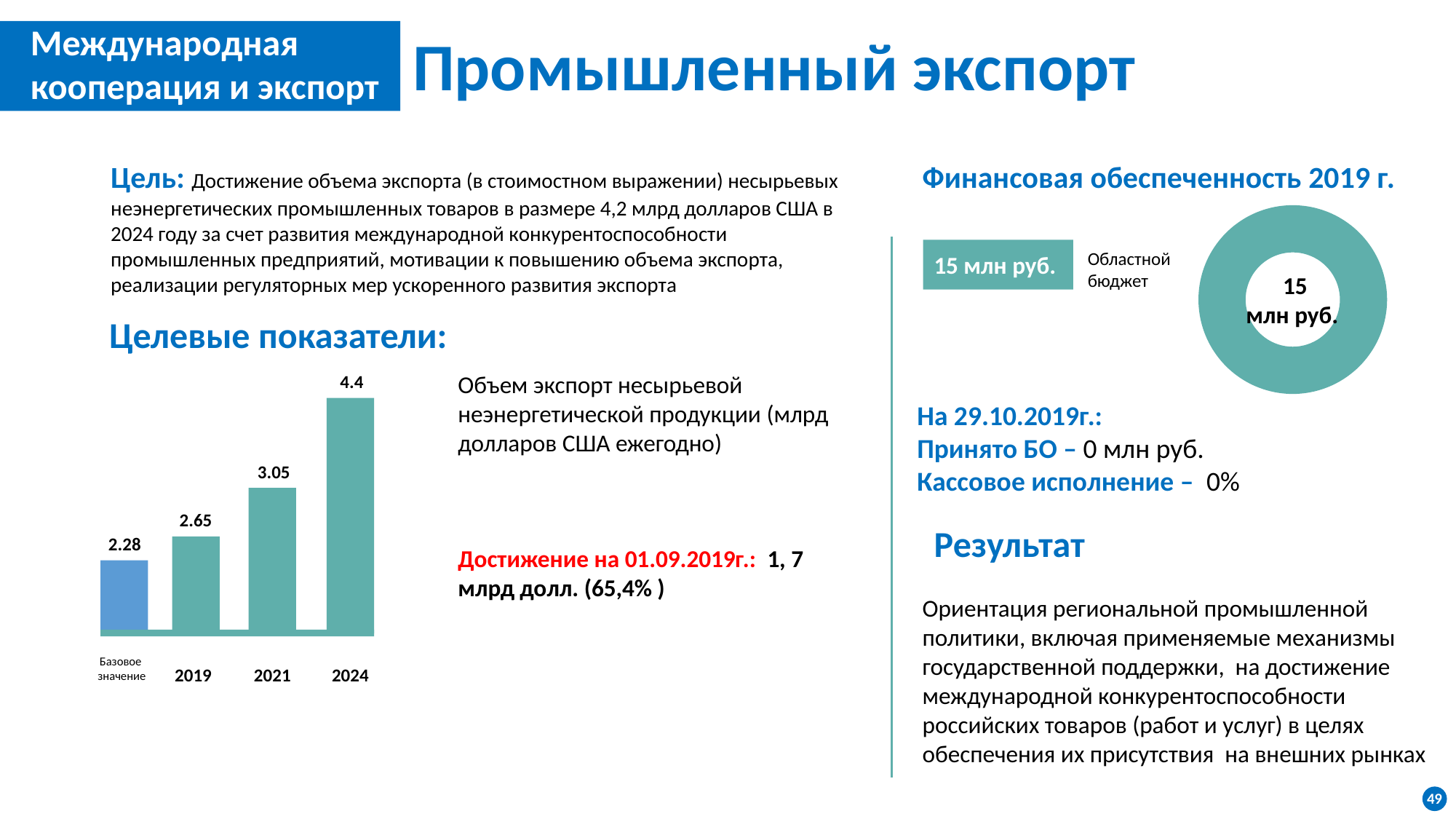
What kind of chart is shown under 'Целевые показатели'? bar chart In the bar chart under 'Целевые показатели', what is the value for 'Базовое значение'? 2.28 In the bar chart under 'Целевые показатели', which category has the highest value? 2024 In the bar chart under 'Целевые показатели', what is the difference between the values for 2024 and 2019? 1.75 How many bars are in the bar chart under 'Целевые показатели'? 4 In the bar chart under 'Целевые показатели', which is larger, the value for 2021 or the value for 2019? 2021 In the donut chart under 'Финансовая обеспеченность 2019 г.', what value is shown in the centre? 15 млн руб. In the bar chart under 'Целевые показатели', which category has the lowest value? Базовое значение In the bar chart under 'Целевые показатели', what is the value for 2024? 4.4 In the bar chart under 'Целевые показатели', what is the value for 2021? 3.05 In the bar chart under 'Целевые показатели', do the values rise or fall from left to right? rise In the bar chart under 'Целевые показатели', what is the value for 2019? 2.65